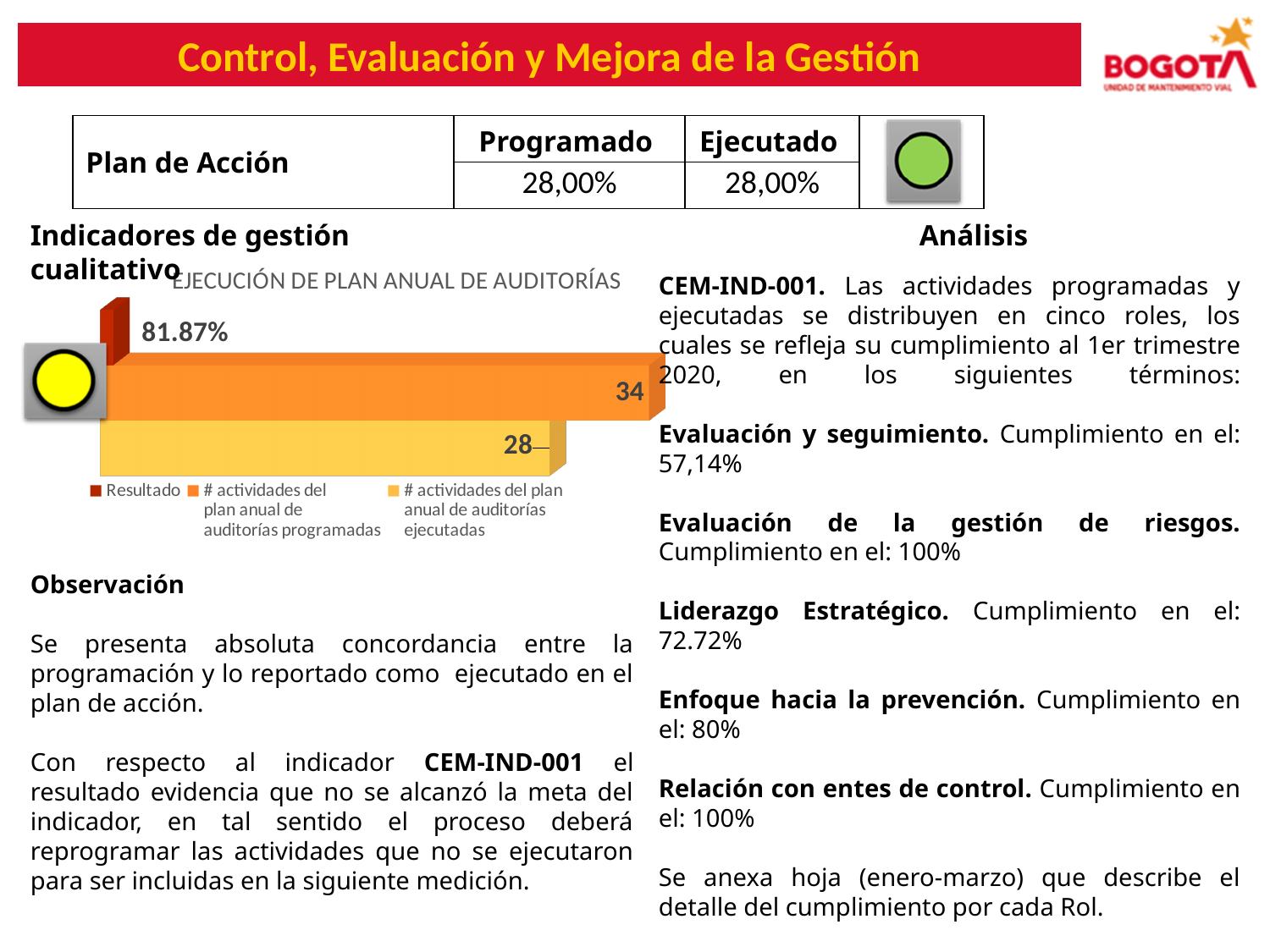
Which colour is used for the "Resultado" series in the chart? dark red What is the title of the chart on the slide? EJECUCIÓN DE PLAN ANUAL DE AUDITORÍAS What is the value shown for "# actividades del plan anual de auditorías programadas"? 34 What is the difference between the programmed activities (34) and the executed activities (28)? 6 What is the value shown for "# actividades del plan anual de auditorías ejecutadas"? 28 What type of chart is shown under "Indicadores de gestión cualitativo"? bar chart Which series in the chart has the longest bar? # actividades del plan anual de auditorías programadas How many series does the chart legend list? 3 How many bars are plotted in the chart? 3 What is the value shown for the "Resultado" series? 81.87% Which is larger, the number of programmed activities or the number of executed activities? # actividades del plan anual de auditorías programadas